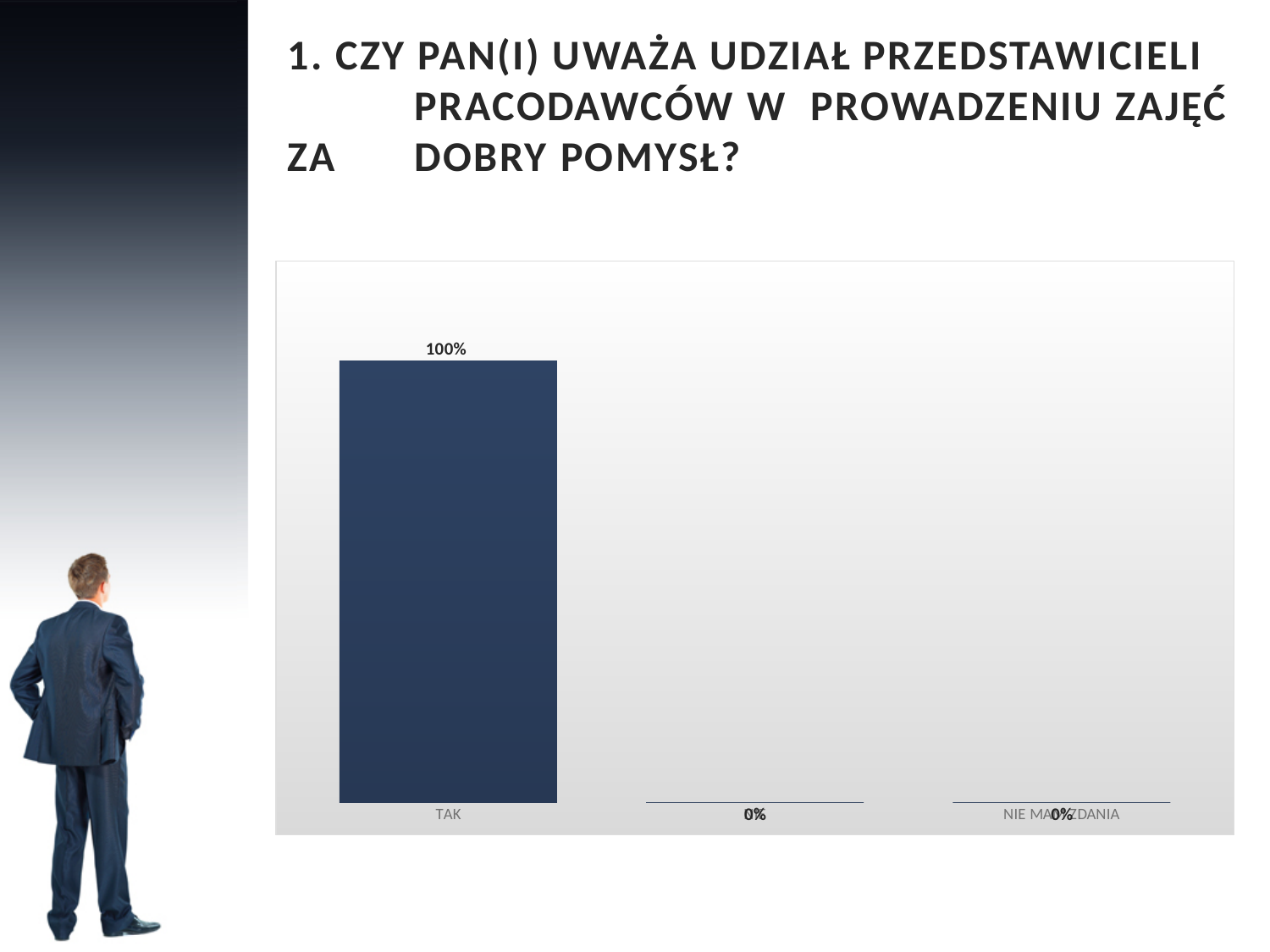
Which is larger, the value for TAK or the value for NIE MAM ZDANIA? TAK Do the values rise or fall from left to right along the x axis? fall What kind of chart is shown on the slide? bar chart Which category has the highest value? TAK What is the value for NIE MAM ZDANIA? 0% How many categories have a value of 0%? 2 What is the difference between the value for TAK and the value for NIE MAM ZDANIA? 100% How many categories are shown on the x axis? 3 What is the value for TAK? 100% Which category is shown first on the left of the x axis? TAK What colour is the bar for TAK? dark blue